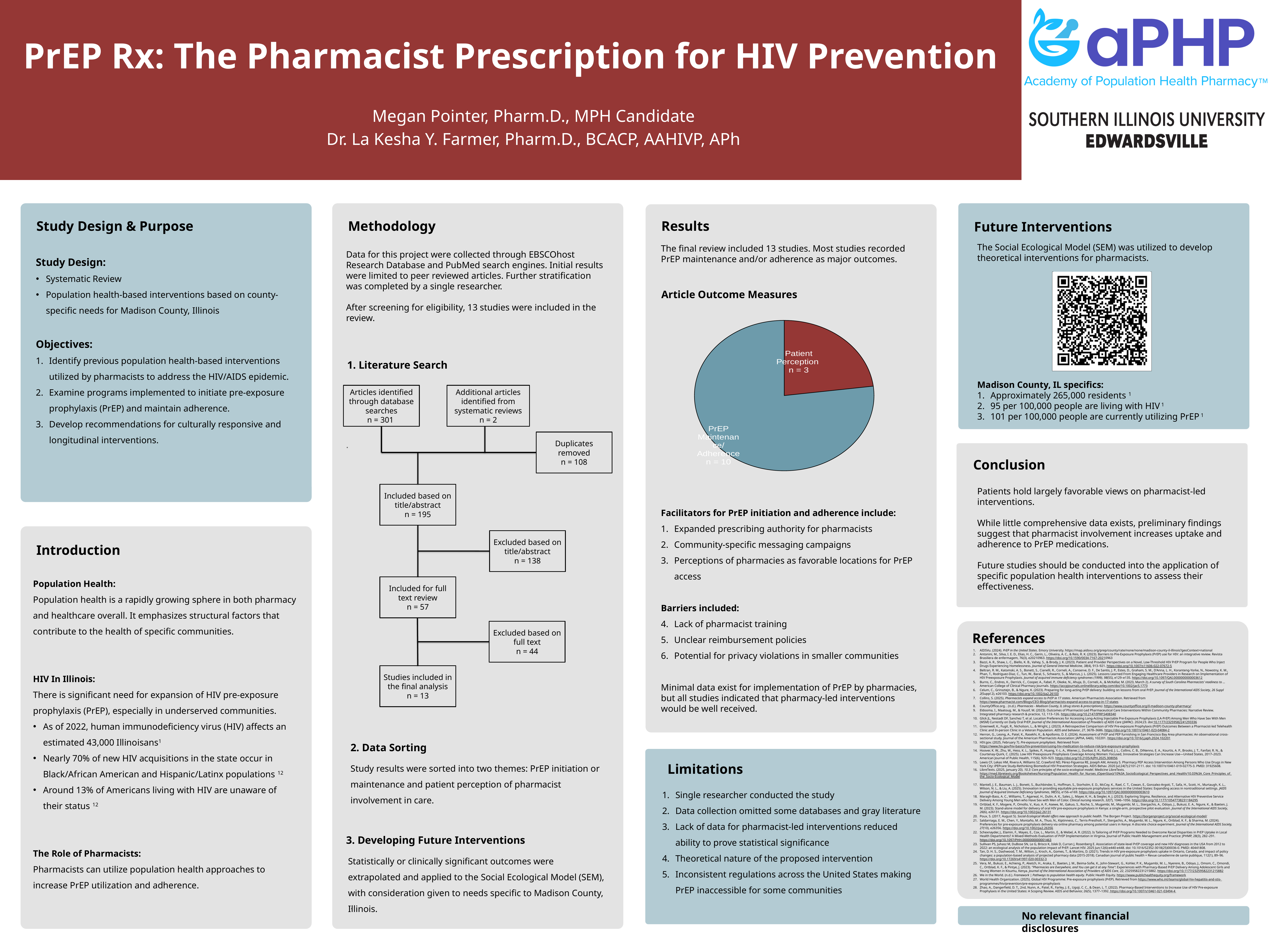
In the "Article Outcome Measures" pie chart, which has more studies: Patient Perception or PrEP Maintenance/Adherence? PrEP Maintenance/Adherence What is the title of the pie chart in the Results section? Article Outcome Measures What colour is the Patient Perception slice in the "Article Outcome Measures" pie chart? dark red What is the total number of studies represented in the "Article Outcome Measures" pie chart? 13 In the "Article Outcome Measures" pie chart, how many studies are in the Patient Perception slice? n = 3 Which slice of the "Article Outcome Measures" pie chart is the largest? PrEP Maintenance/Adherence In the "Article Outcome Measures" pie chart, how many studies are in the PrEP Maintenance/Adherence slice? n = 10 In the "Article Outcome Measures" pie chart, how many more studies are in PrEP Maintenance/Adherence than in Patient Perception? 7 What kind of chart is shown under "Article Outcome Measures"? pie chart Which slice of the "Article Outcome Measures" pie chart is the smallest? Patient Perception How many slices does the "Article Outcome Measures" pie chart have? 2